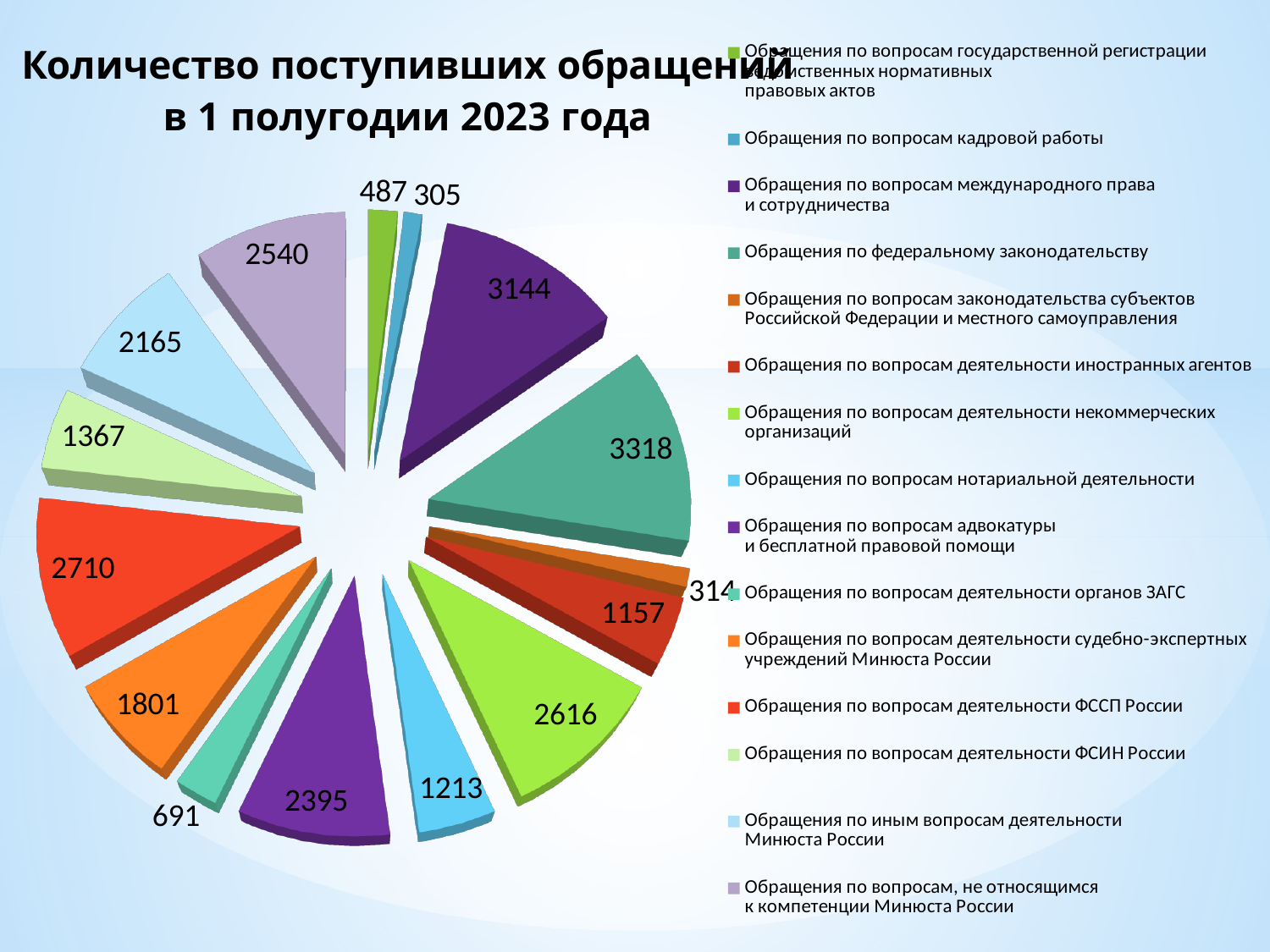
What is the value for "Обращения по вопросам деятельности ФССП России"? 2710 What type of chart is shown on the slide? Pie chart Which category has the smallest value? Обращения по вопросам кадровой работы What is the value for "Обращения по вопросам кадровой работы"? 305 What is the value for "Обращения по вопросам международного права и сотрудничества"? 3144 What is the title of the chart? Количество поступивших обращений в 1 полугодии 2023 года Which category has the largest value? Обращения по федеральному законодательству Which is larger: the value for "Обращения по вопросам деятельности ФСИН России" or the value for "Обращения по иным вопросам деятельности Минюста России"? Обращения по иным вопросам деятельности Минюста России What is the value for "Обращения по федеральному законодательству"? 3318 What is the difference between the values for "Обращения по федеральному законодательству" and "Обращения по вопросам международного права и сотрудничества"? 174 How many categories does the legend list? 15 What is the difference between the values for "Обращения по вопросам деятельности некоммерческих организаций" and "Обращения по вопросам нотариальной деятельности"? 1403